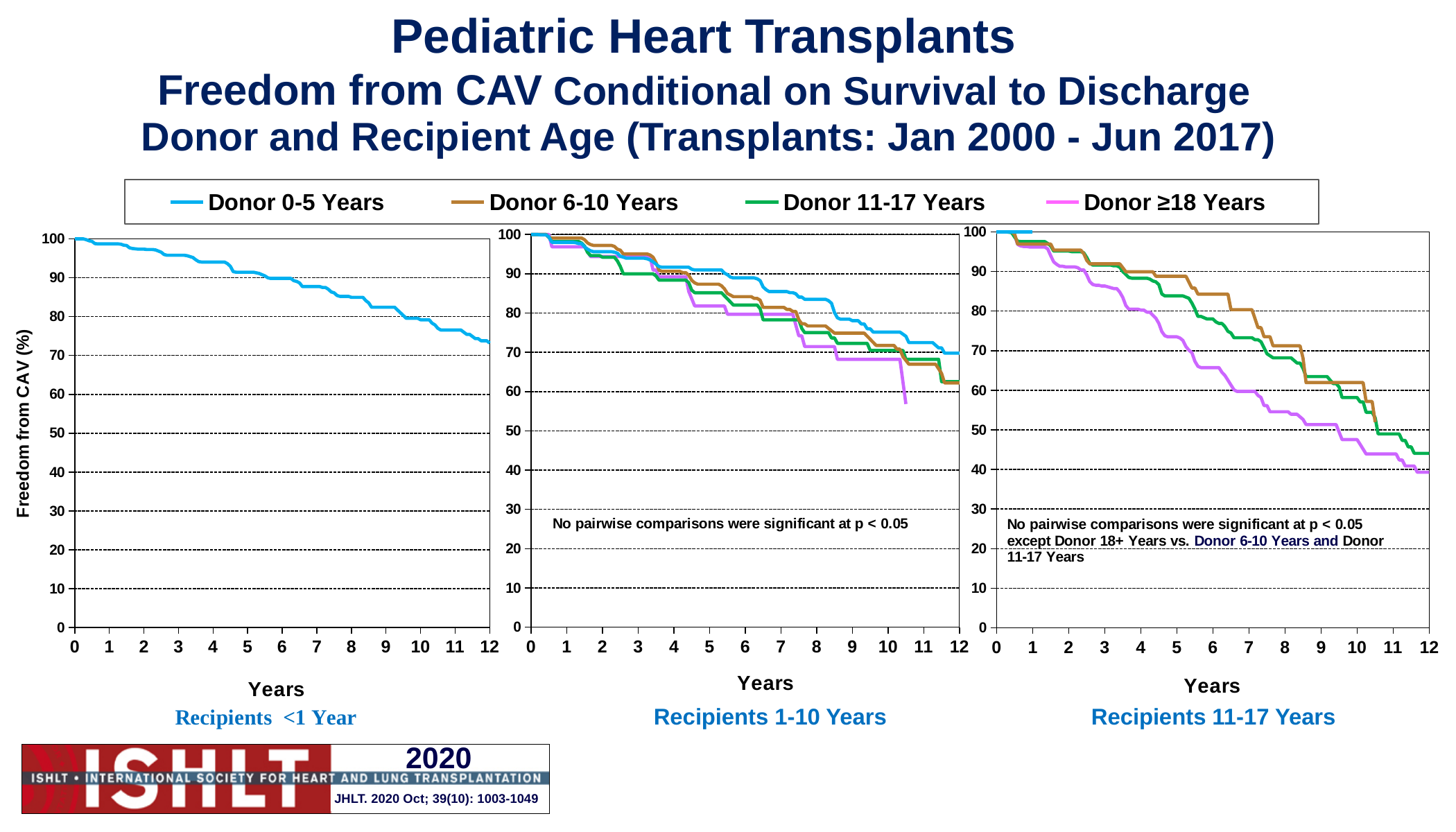
In the Recipients 11-17 Years chart, at 8 years, which is larger: Donor 6-10 Years or Donor ≥18 Years? Donor 6-10 Years In the Recipients <1 Year chart, does freedom from CAV rise or fall as years since transplant increase? Fall In the Recipients 1-10 Years chart, is the value for Donor ≥18 Years at 10 years greater or less than 80? less What kind of chart is used for the Recipients <1 Year panel? Line chart In the Recipients 11-17 Years chart, which donor age group has the lowest freedom from CAV at 10 years? Donor ≥18 Years How many charts (recipient age panels) are shown on the slide? 3 In the Recipients 1-10 Years chart, is the value for Donor 0-5 Years at 12 years greater or less than 60? greater In the Recipients 11-17 Years chart, is the value for Donor ≥18 Years at 12 years greater or less than 50? less What is the label on the y axis of the charts? Freedom from CAV (%) How many donor age series does the legend list? 4